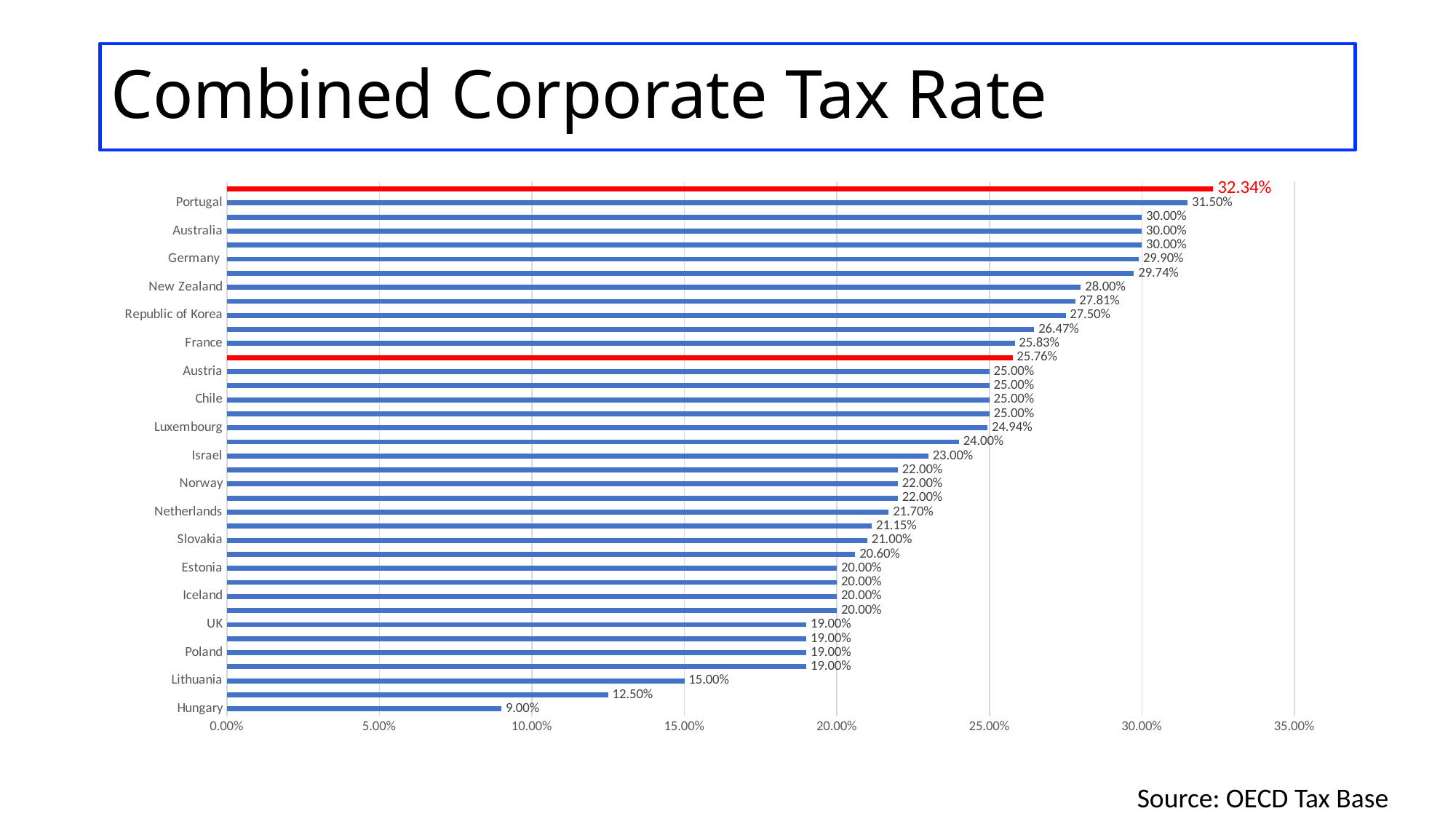
What is the combined corporate tax rate shown for Hungary? 9.00% How many bars are coloured red in the chart? 2 Which has the higher combined corporate tax rate, Germany or New Zealand? Germany Is the value for Israel greater or less than 25.00%? less What is the value of the longest bar in the chart? 32.34% What is the difference between Portugal's rate and Hungary's rate? 22.50% Which labelled country has the lowest combined corporate tax rate? Hungary What kind of chart is shown on the slide? bar chart What is the combined corporate tax rate shown for Lithuania? 15.00% What is the combined corporate tax rate shown for Portugal? 31.50% What is the combined corporate tax rate shown for Germany? 29.90% What is the combined corporate tax rate shown for France? 25.83%